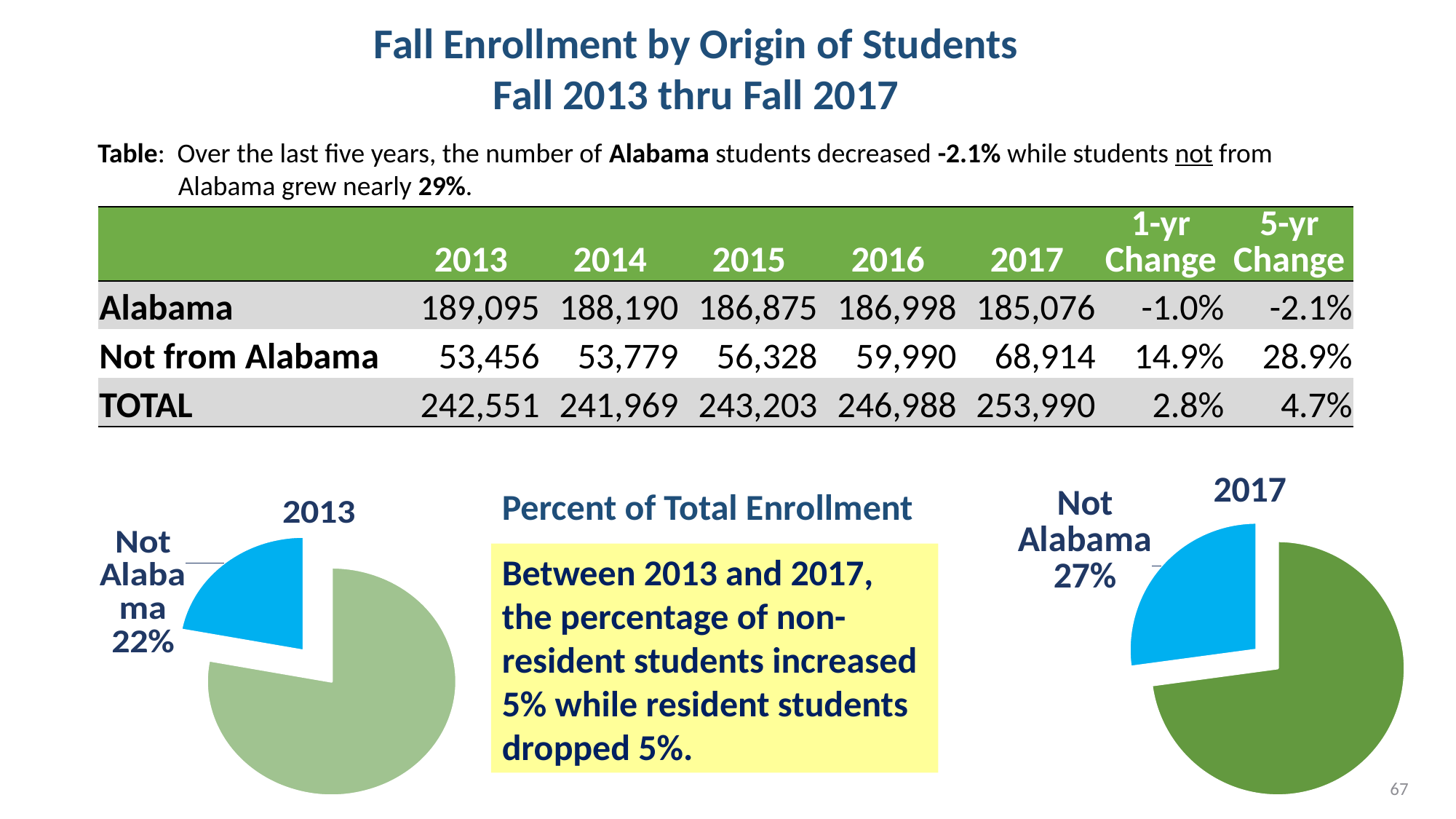
In the 2017 pie chart, what share of total enrollment is labelled for Not Alabama? 27% Is the Not Alabama share larger in the 2013 pie chart or the 2017 pie chart? 2017 What heading appears between the two pie charts? Percent of Total Enrollment In the 2013 pie chart, what share of total enrollment is labelled for Not Alabama? 22% How many pie charts are shown on the slide? 2 By how many percentage points does the Not Alabama share in the 2017 pie chart exceed the Not Alabama share in the 2013 pie chart? 5% In the 2013 pie chart, is the Not Alabama slice the larger or the smaller slice? smaller Does the Not Alabama share of enrollment rise or fall from the 2013 pie chart to the 2017 pie chart? rise In the 2017 pie chart, is the Not Alabama slice the larger or the smaller slice? smaller How many slices does the 2017 pie chart have? 2 What kind of chart is used to show the 2013 and 2017 enrollment shares? pie chart What colour is the Not Alabama slice in the 2013 pie chart? blue